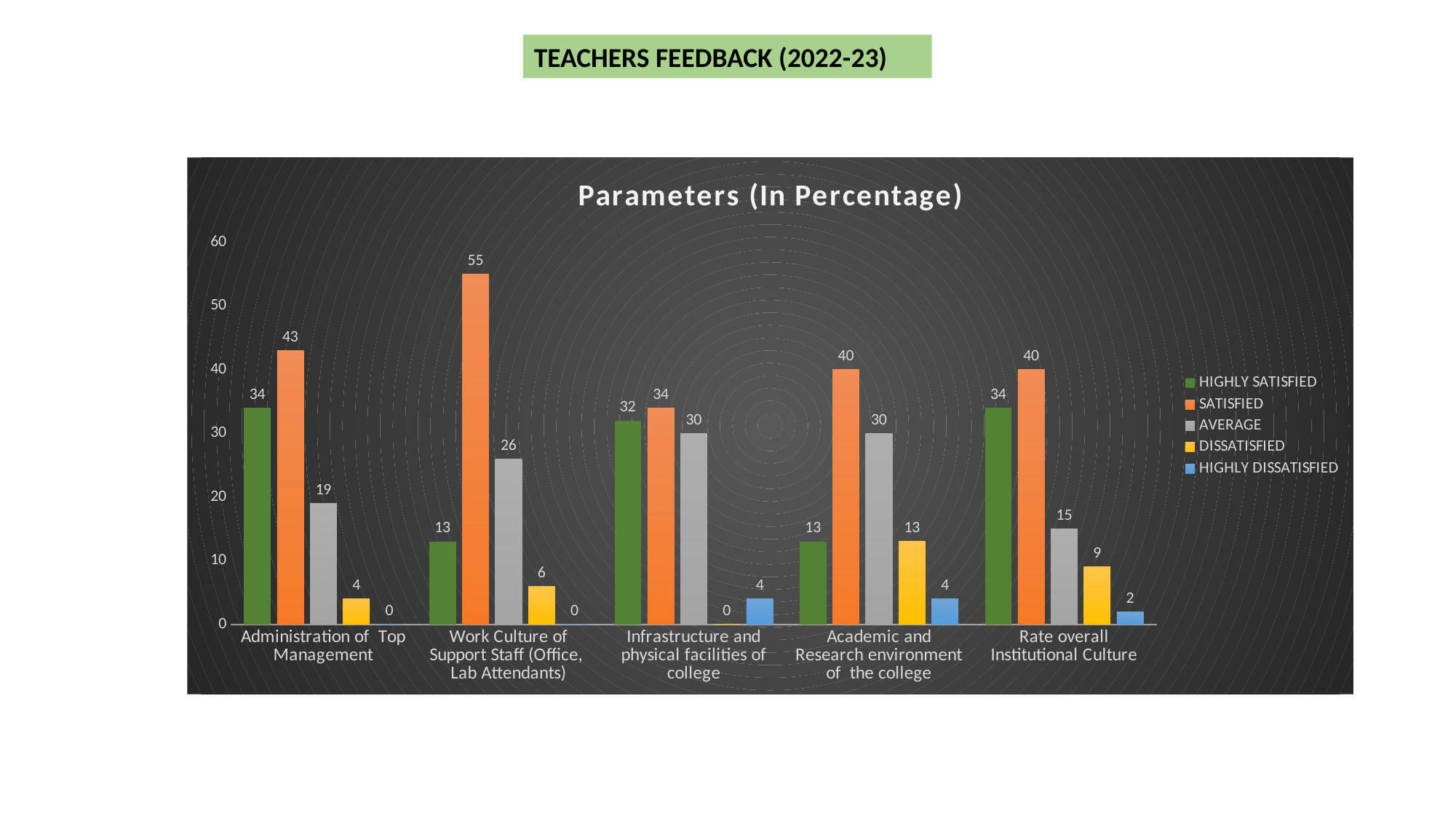
What is the AVERAGE value for Administration of Top Management? 19 What kind of chart is shown on the slide? Bar chart What is the DISSATISFIED value for Infrastructure and physical facilities of college? 0 What is the difference between the SATISFIED and HIGHLY SATISFIED values for Administration of Top Management? 9 What is the title of the chart? Parameters (In Percentage) Which category has the highest SATISFIED value? Work Culture of Support Staff (Office, Lab Attendants) What is the HIGHLY DISSATISFIED value for Rate overall Institutional Culture? 2 Which category has the lowest HIGHLY SATISFIED value? Work Culture of Support Staff (Office, Lab Attendants) and Academic and Research environment of the college (both 13) What is the SATISFIED value for Work Culture of Support Staff (Office, Lab Attendants)? 55 How many series does the legend list? 5 How many categories are shown on the x axis? 5 Which is larger for Infrastructure and physical facilities of college: HIGHLY SATISFIED or AVERAGE? HIGHLY SATISFIED